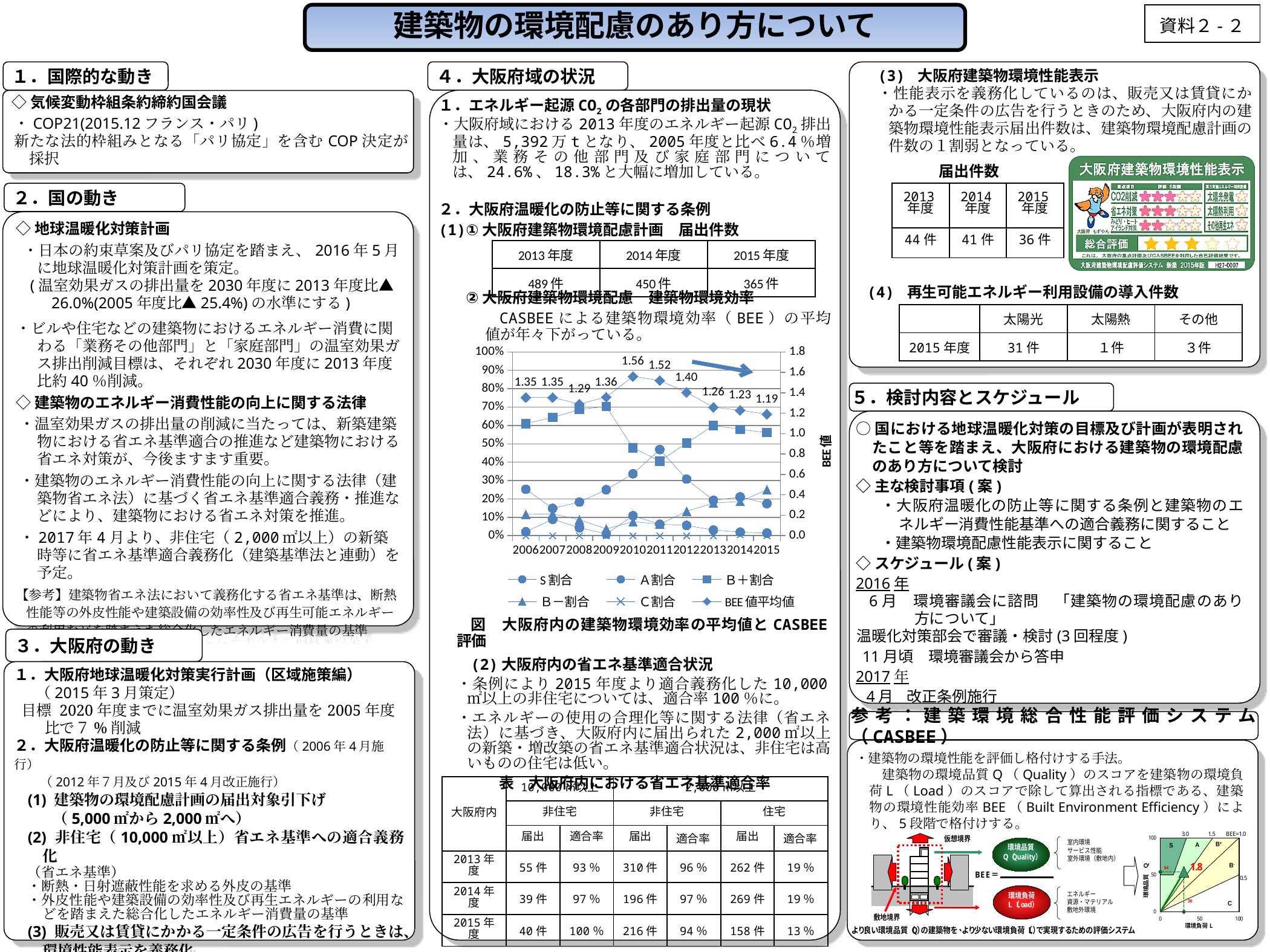
Does the BEE値平均値 rise or fall from 2010 to 2015? fall What is the BEE値平均値 for 2010 in the chart? 1.56 What is the BEE値平均値 for 2015 in the chart? 1.19 In which year is the BEE値平均値 lowest? 2015 Is the value for A割合 in 2010 greater or less than 50%? less Which year has a larger BEE値平均値, 2011 or 2013? 2011 In which year is the BEE値平均値 highest? 2010 What is the BEE値平均値 for 2006 in the chart? 1.35 What is the difference between the BEE値平均値 in 2010 and in 2015? 0.37 How many series does the chart's legend list? 6 Is the value for B＋割合 in 2013 greater or less than 50%? greater How many years are plotted on the x axis of the chart? 10